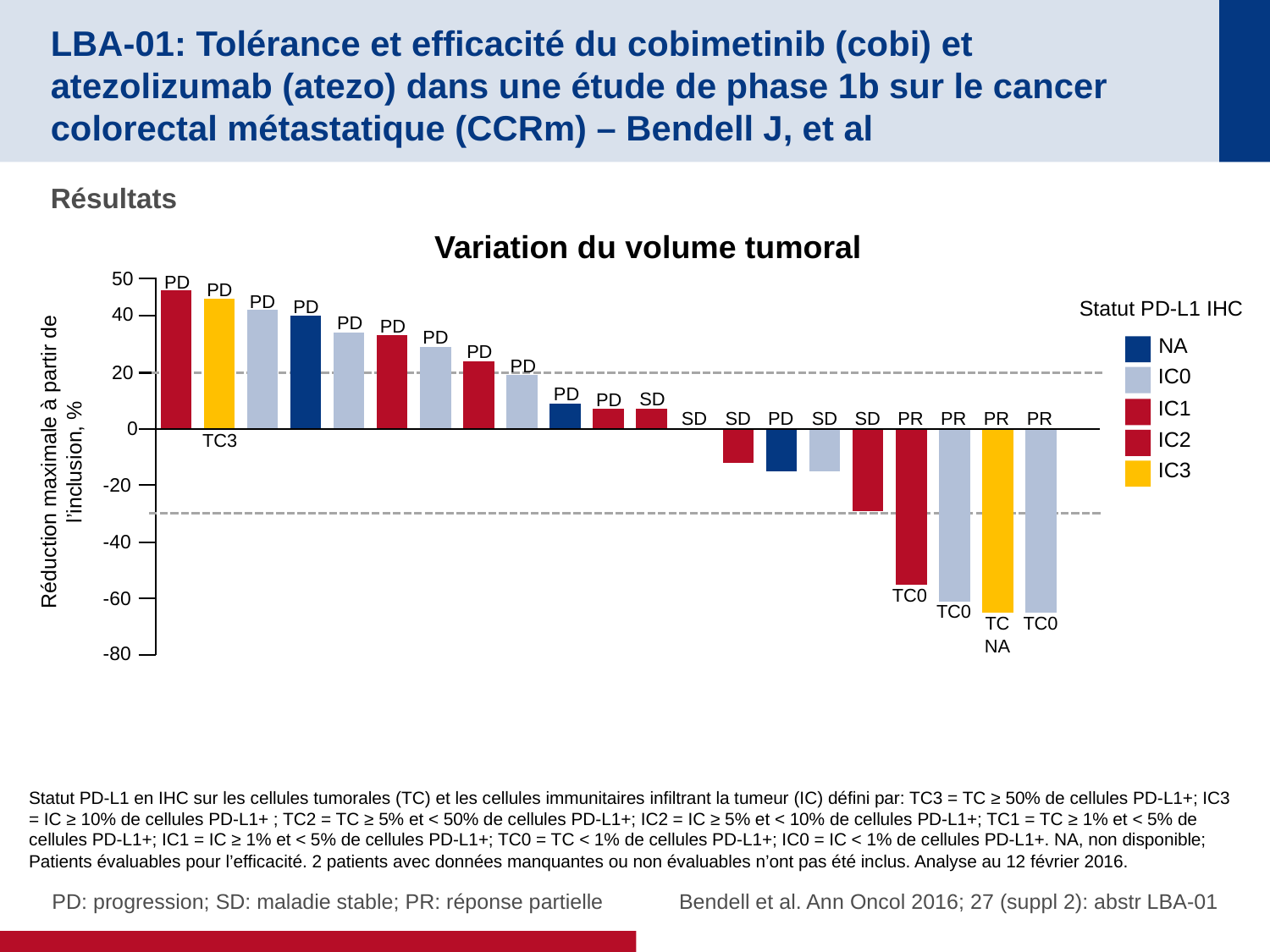
How many entries does the legend 'Statut PD-L1 IHC' list? 5 Is the value of the dark blue PD bar near the middle of the chart (after the SD bars) greater or less than 0? less How many bars are labelled PR? 4 Do the bar values rise or fall from left to right along the x axis? fall Which colour represents IC3 in the legend? Yellow What is the highest tick value shown on the y axis? 50 Is the value of the rightmost PR bar (labelled TC0) greater or less than -40? less What kind of chart is shown under the title 'Variation du volume tumoral'? Bar chart What is the title of the chart? Variation du volume tumoral Is the value of the first PR bar (labelled TC0) greater or less than -40? less Which is larger: the leftmost PD bar or the fourth PD bar (dark blue)? The leftmost PD bar